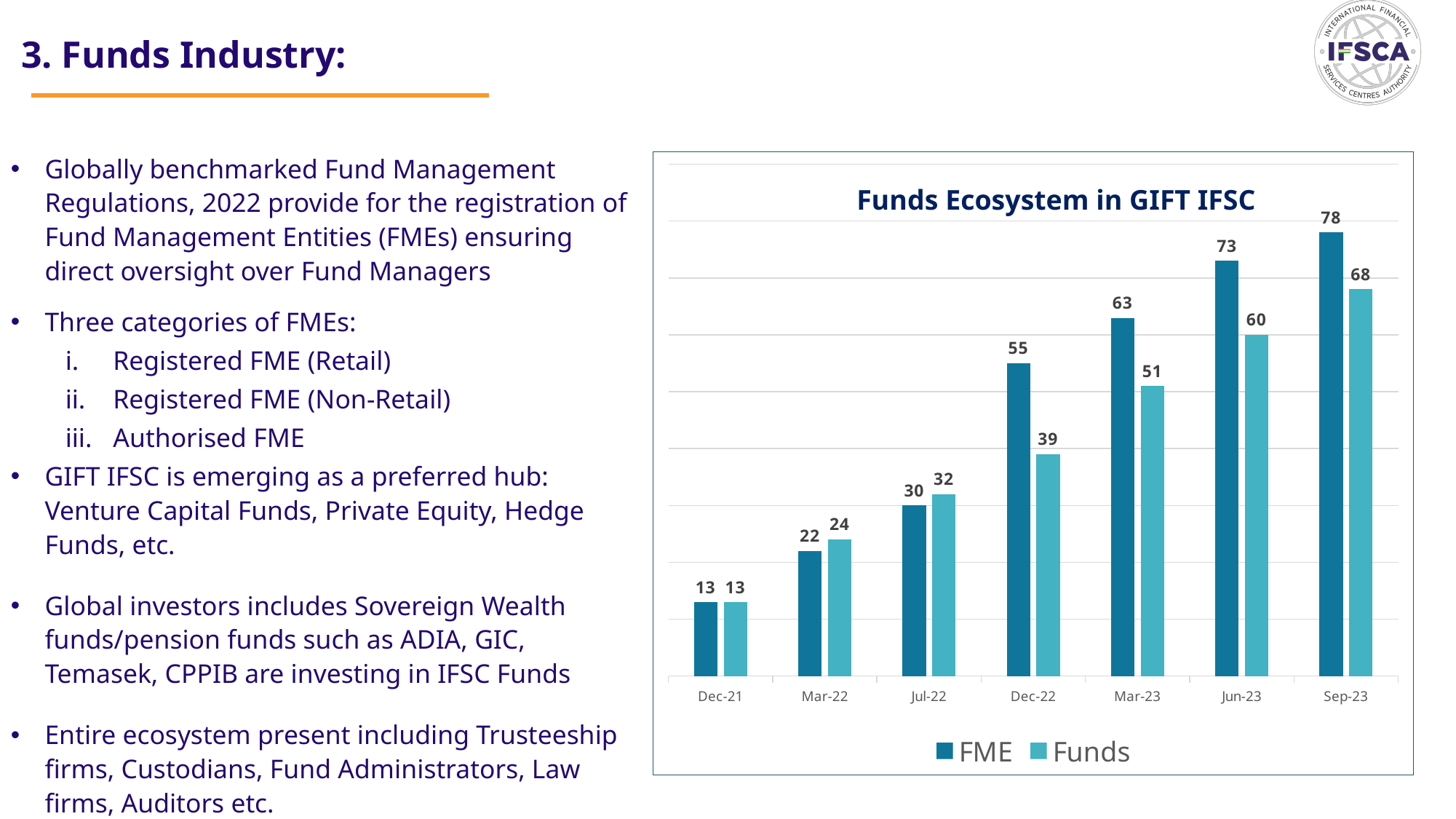
How many series does the legend list? 2 Do the FME values rise or fall from Dec-21 to Sep-23? Rise What kind of chart is shown? Bar chart What is the FME value for Dec-22? 55 Which period has the highest FME value? Sep-23 Which is larger for Jul-22, the FME value or the Funds value? Funds What is the Funds value for Jun-23? 60 What is the Funds value for Mar-22? 24 What is the difference between the FME and Funds values for Mar-23? 12 How many periods are shown on the x axis? 7 What is the title of the chart? Funds Ecosystem in GIFT IFSC Which period has the lowest Funds value? Dec-21